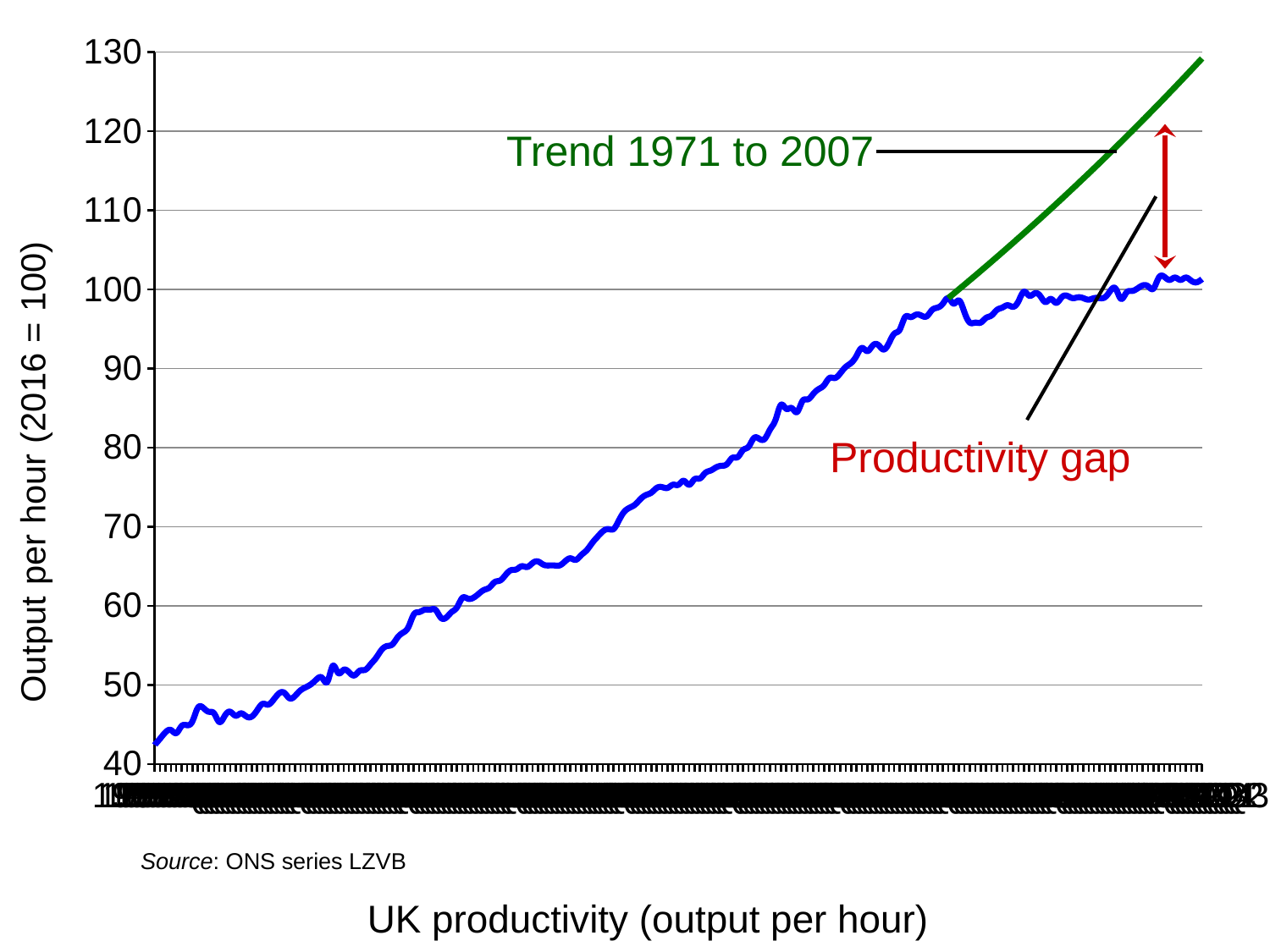
Does the blue productivity line generally rise or fall from left to right across the chart? Rise What is the highest value shown on the vertical axis? 130 What does the red double-headed arrow on the chart represent? Productivity gap Is the value at the left-hand start of the blue productivity line greater or less than 50? less At the right-hand end of the chart, which line is higher: the green trend line or the blue productivity line? The green trend line What is the title of the chart? UK productivity (output per hour) What is the lowest value shown on the vertical axis? 40 Is the value at the right-hand end of the green trend line greater or less than 120? greater What period does the green trend line cover, according to its label? 1971 to 2007 What kind of chart is shown on the slide? Line chart Is the value at the right-hand end of the blue productivity line greater or less than 110? less What is the label on the vertical axis of the chart? Output per hour (2016 = 100)